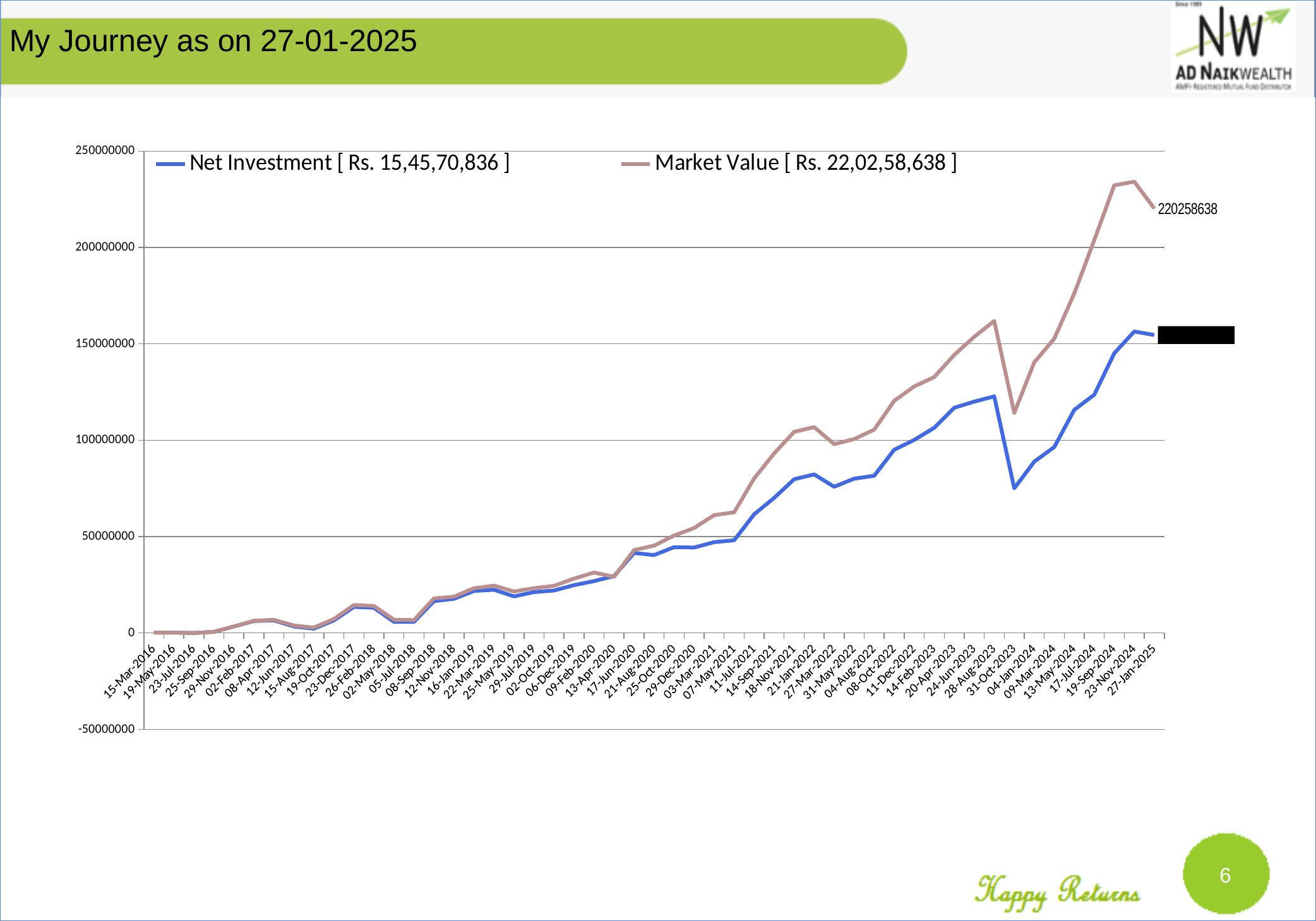
What is the full legend entry for the Market Value series? Market Value [ Rs. 22,02,58,638 ] Is the Market Value on 27-Jan-2025 greater or less than 200000000? greater Is the Net Investment on 27-Jan-2025 greater or less than 200000000? less What is the full legend entry for the Net Investment series? Net Investment [ Rs. 15,45,70,836 ] Using the amounts in the legend, what is the difference between the Market Value and the Net Investment? Rs. 6,56,87,802 Which series reaches the highest value anywhere on the chart? Market Value Is the Net Investment on 15-Mar-2016 greater or less than 50000000? less What is the Market Value data label shown at the end of the line on 27-Jan-2025? 220258638 How many series does the chart legend list? 2 What kind of chart is shown on the slide? line chart On 27-Jan-2025, which is larger, the Market Value or the Net Investment? Market Value Does the Net Investment line generally rise or fall from 15-Mar-2016 to 27-Jan-2025? rise